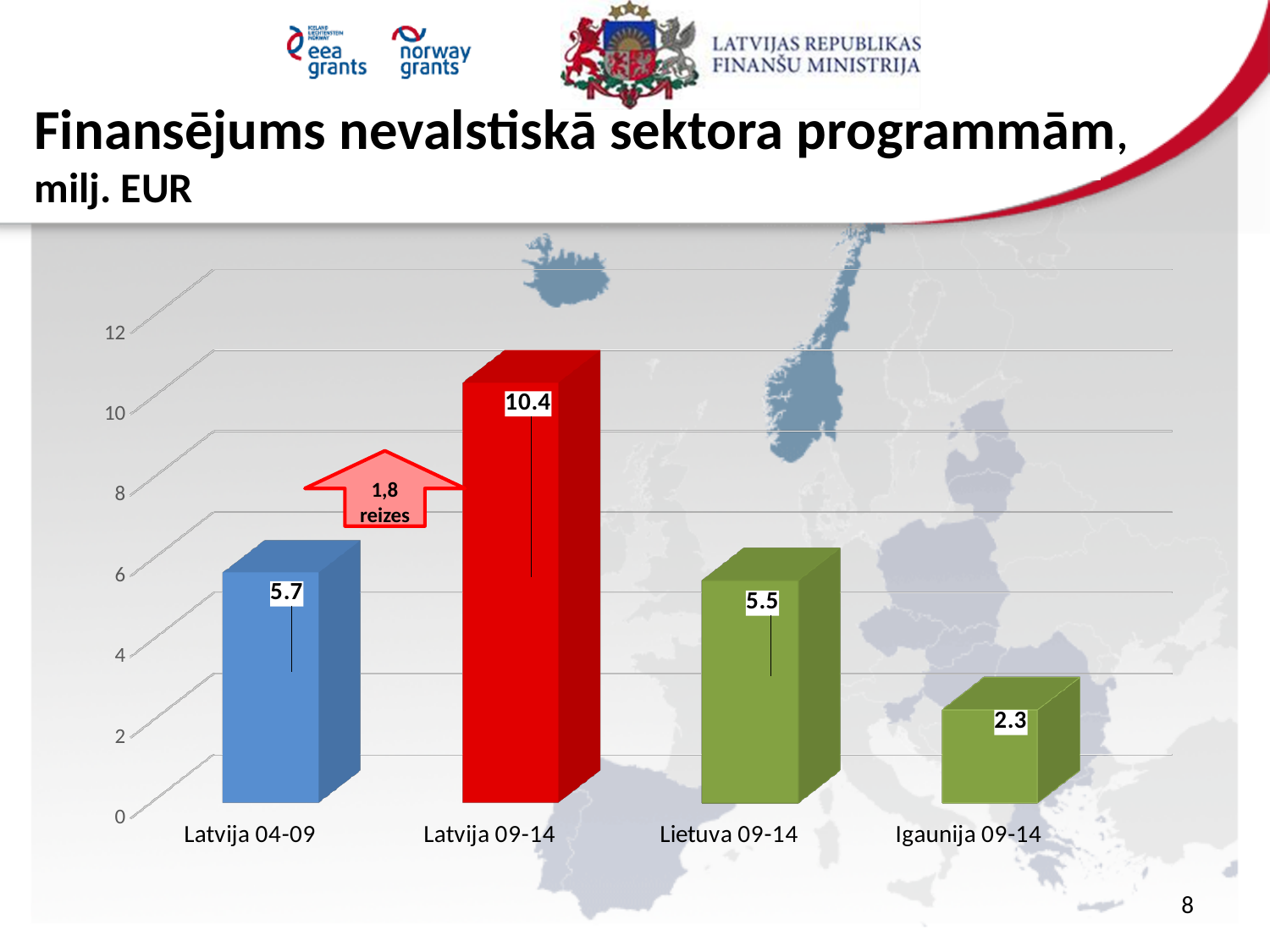
What is the value for Igaunija 09-14? 2.3 What is the difference between the values for Lietuva 09-14 and Igaunija 09-14? 3.2 What unit is stated in the chart title? milj. EUR Which is larger, the value for Latvija 09-14 or the value for Lietuva 09-14? Latvija 09-14 What is the difference between the values for Latvija 09-14 and Latvija 04-09? 4.7 Which category has the highest value? Latvija 09-14 What is the value for Latvija 04-09? 5.7 How many categories are shown on the chart? 4 What is the value for Lietuva 09-14? 5.5 What is the value for Latvija 09-14? 10.4 Which category has the lowest value? Igaunija 09-14 What kind of chart is shown on the slide? bar chart